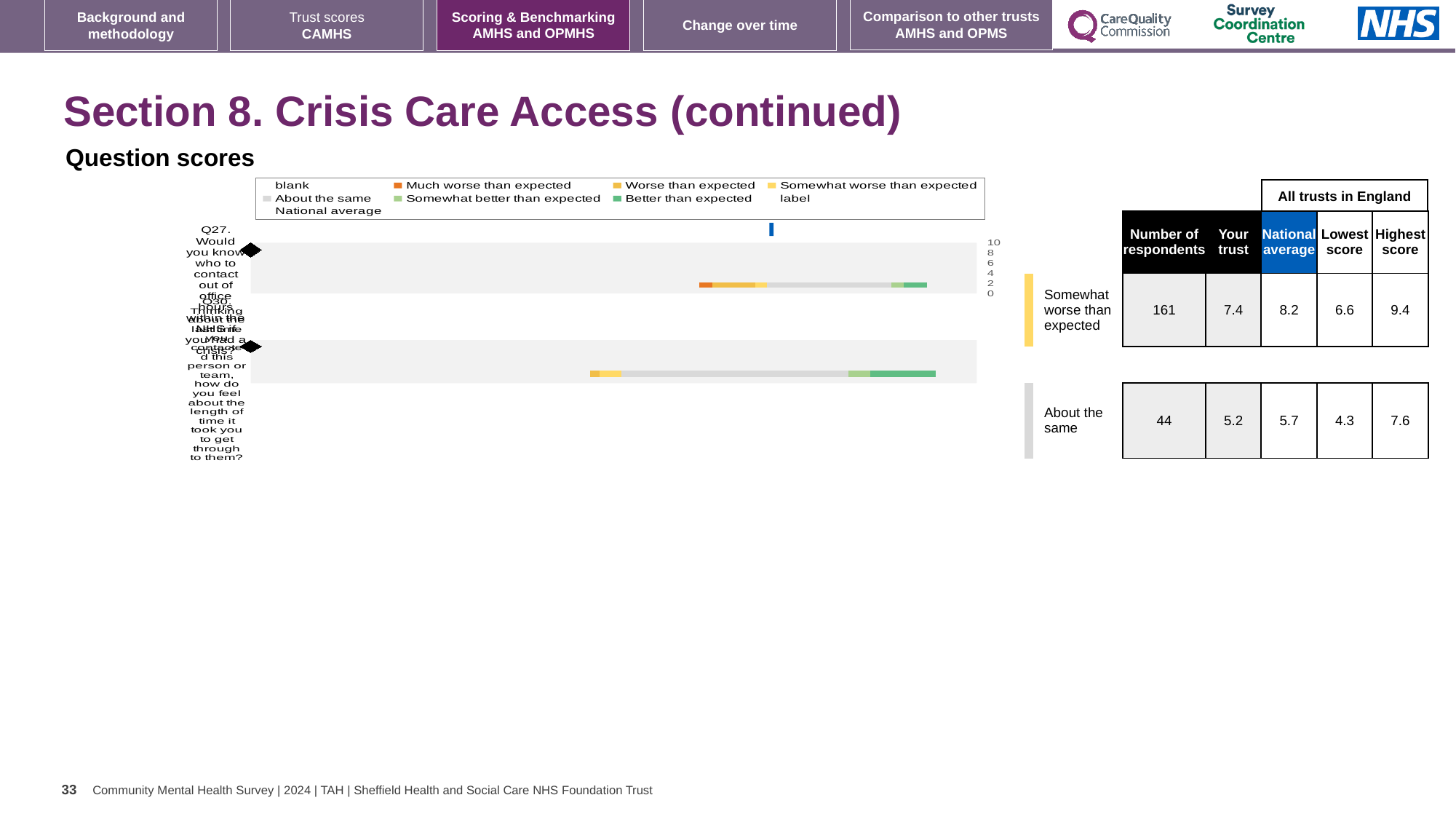
In the table beside the chart, which question has the higher 'Your trust' score, Q27 or Q30? Q27 In the table beside the chart, what is the 'Your trust' score for the first question (Q27)? 7.4 What kind of chart is shown under 'Question scores'? bar chart In the table beside the chart, what is the difference between the national average and 'Your trust' score for Q30? 0.5 In the table beside the chart, what is the difference between the highest score and the lowest score for Q27? 2.8 In the table beside the chart, what is the national average for Q27? 8.2 In the table beside the chart, how many respondents answered Q30? 44 How many entries does the chart legend list? 9 Which legend entry is shown in dark green? Better than expected How many question categories are plotted in the chart? 2 Which legend entry is shown in orange? Much worse than expected In the table beside the chart, what is the 'Your trust' score for the second question (Q30)? 5.2